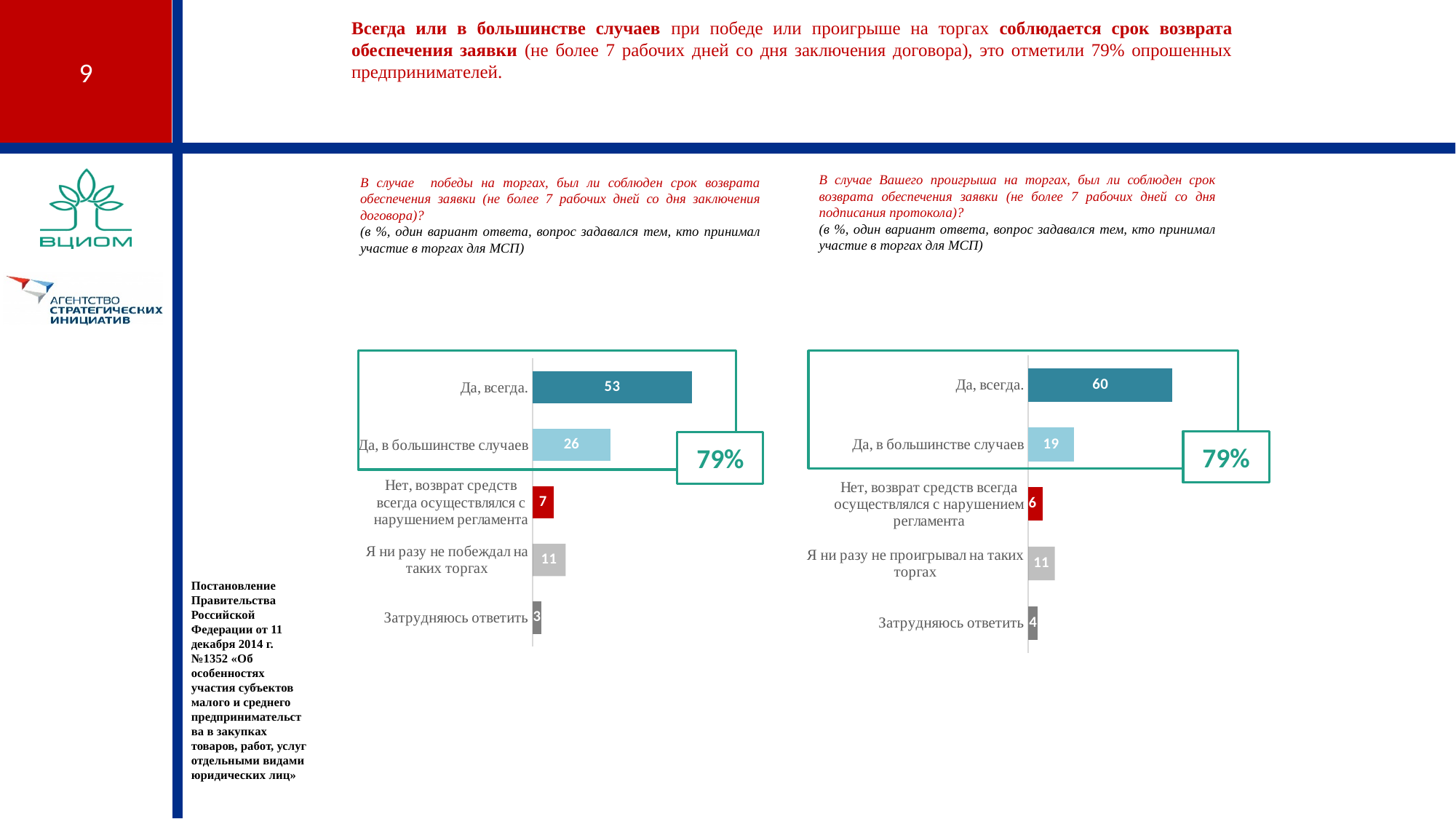
Which is larger: "Да, всегда." in the left chart or "Да, всегда." in the right chart? Right chart (60) In the left chart, what is the value for "Да, в большинстве случаев"? 26 In the right chart (about losing at auctions), what is the value for "Да, всегда."? 60 In the left chart (about winning at auctions), what is the value for "Да, всегда."? 53 In the left chart, which category has the lowest value? Затрудняюсь ответить How many categories does the left chart show? 5 What combined percentage is highlighted in the box next to the two "Да" categories in the left chart? 79% What type of chart is used on the right side of the slide? Bar chart In the left chart, what is the difference between "Да, всегда." and "Да, в большинстве случаев"? 27 In the right chart, what is the value for "Затрудняюсь ответить"? 4 In the right chart, what is the difference between "Да, в большинстве случаев" and "Нет, возврат средств всегда осуществлялся с нарушением регламента"? 13 In the right chart, which category has the highest value? Да, всегда.